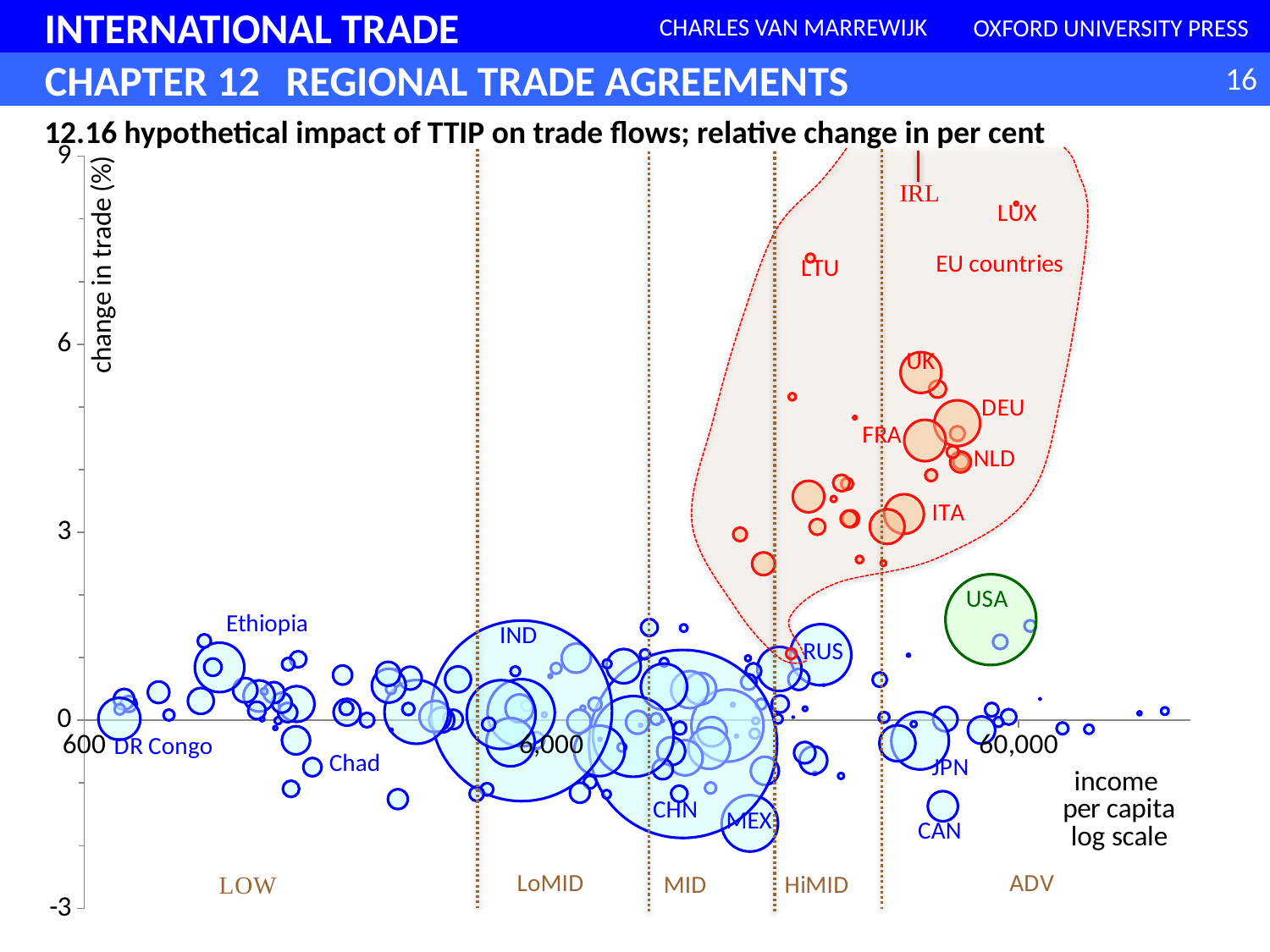
Is the change in trade for LUX greater or less than 6? greater Is the change in trade for CAN greater or less than 0? less What kind of chart is shown on the slide? bubble (scatter) chart Is the change in trade for USA greater or less than 3? less What is the title of the chart? 12.16 hypothetical impact of TTIP on trade flows; relative change in per cent Which labelled country has the highest change in trade on the chart? IRL What does the vertical axis of the chart measure? change in trade (%) Which has the larger change in trade, IRL or USA? IRL How many income groups are labelled along the bottom of the chart? 5